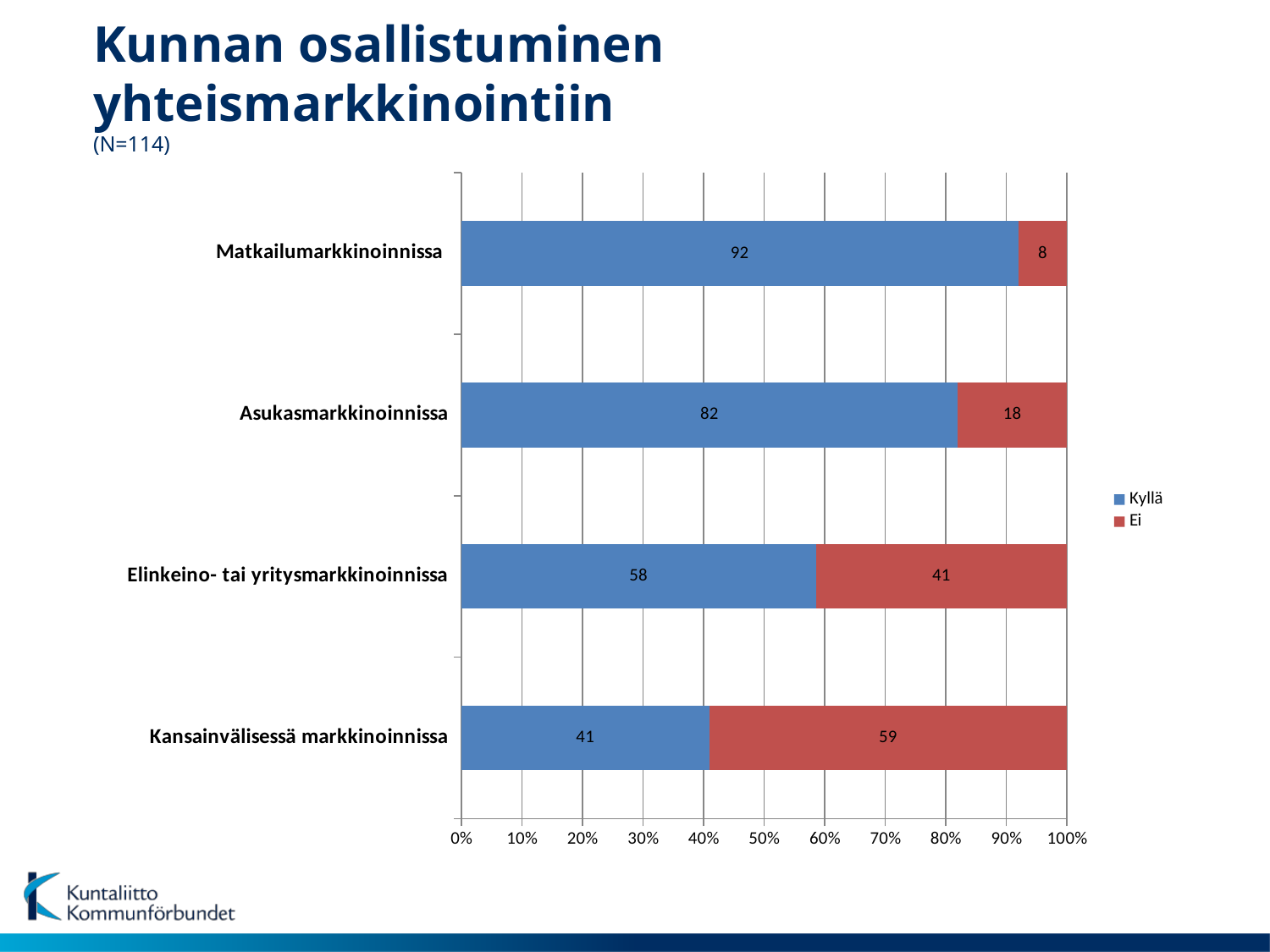
What is the difference between the Kyllä values for Matkailumarkkinoinnissa and Asukasmarkkinoinnissa? 10 How many series does the legend list? 2 What kind of chart is shown on the slide? Stacked bar chart Which category has the highest Kyllä value? Matkailumarkkinoinnissa Which category has the lowest Ei value? Matkailumarkkinoinnissa What is the Ei value for Elinkeino- tai yritysmarkkinoinnissa? 41 How many categories are shown on the chart? 4 What is the sample size (N) given under the chart title? N=114 Which is larger: the Kyllä value for Elinkeino- tai yritysmarkkinoinnissa or the Kyllä value for Kansainvälisessä markkinoinnissa? Elinkeino- tai yritysmarkkinoinnissa What is the Ei value for Asukasmarkkinoinnissa? 18 What is the Kyllä value for Matkailumarkkinoinnissa? 92 What is the Kyllä value for Kansainvälisessä markkinoinnissa? 41